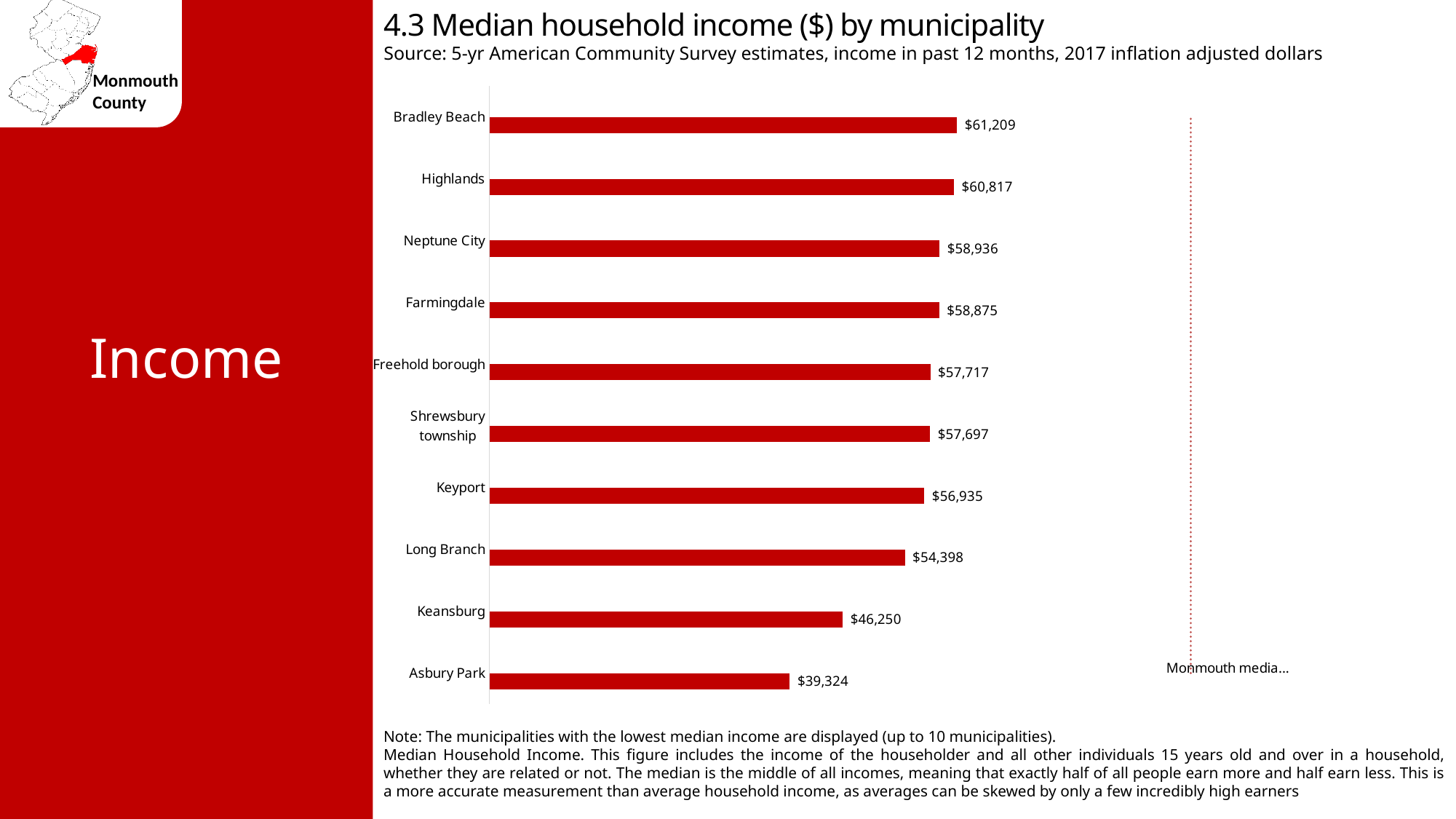
What is the difference in median household income between Keansburg and Asbury Park? $6,926 Which municipality has the highest median household income on the chart? Bradley Beach What is the median household income for Long Branch? $54,398 What is the median household income for Shrewsbury township? $57,697 What is the median household income for Bradley Beach? $61,209 Which has a higher median household income, Long Branch or Keansburg? Long Branch How many municipalities are shown on the chart? 10 What kind of chart is shown on the slide? Bar chart What is the median household income for Keansburg? $46,250 Which municipality has the lowest median household income on the chart? Asbury Park What is the median household income for Asbury Park? $39,324 What is the difference in median household income between Bradley Beach and Asbury Park? $21,885